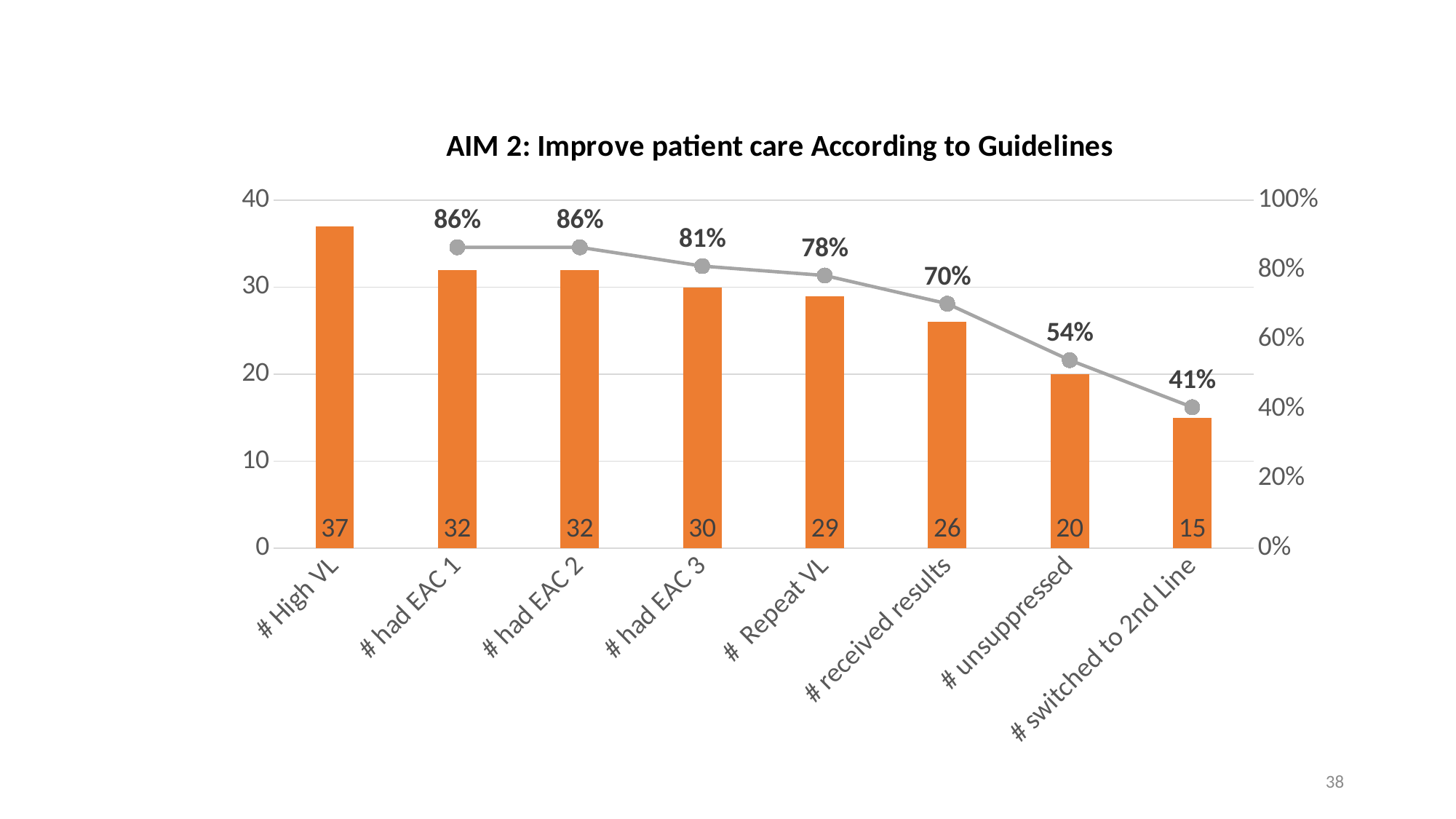
What is the title of the chart? AIM 2: Improve patient care According to Guidelines What is the difference between the bar values for "# High VL" and "# Repeat VL"? 8 Which category has the lowest bar value? # switched to 2nd Line What percentage is shown on the line for "# had EAC 3"? 81% What colour are the bars in the chart? orange What percentage is shown on the line for "# unsuppressed"? 54% What is the bar value for "# switched to 2nd Line"? 15 How many categories are shown on the x axis? 8 Do the bar values rise or fall from left to right along the x axis? fall Which has a larger bar value, "# received results" or "# unsuppressed"? # received results What is the bar value for "# High VL"? 37 Which category has the highest bar value? # High VL